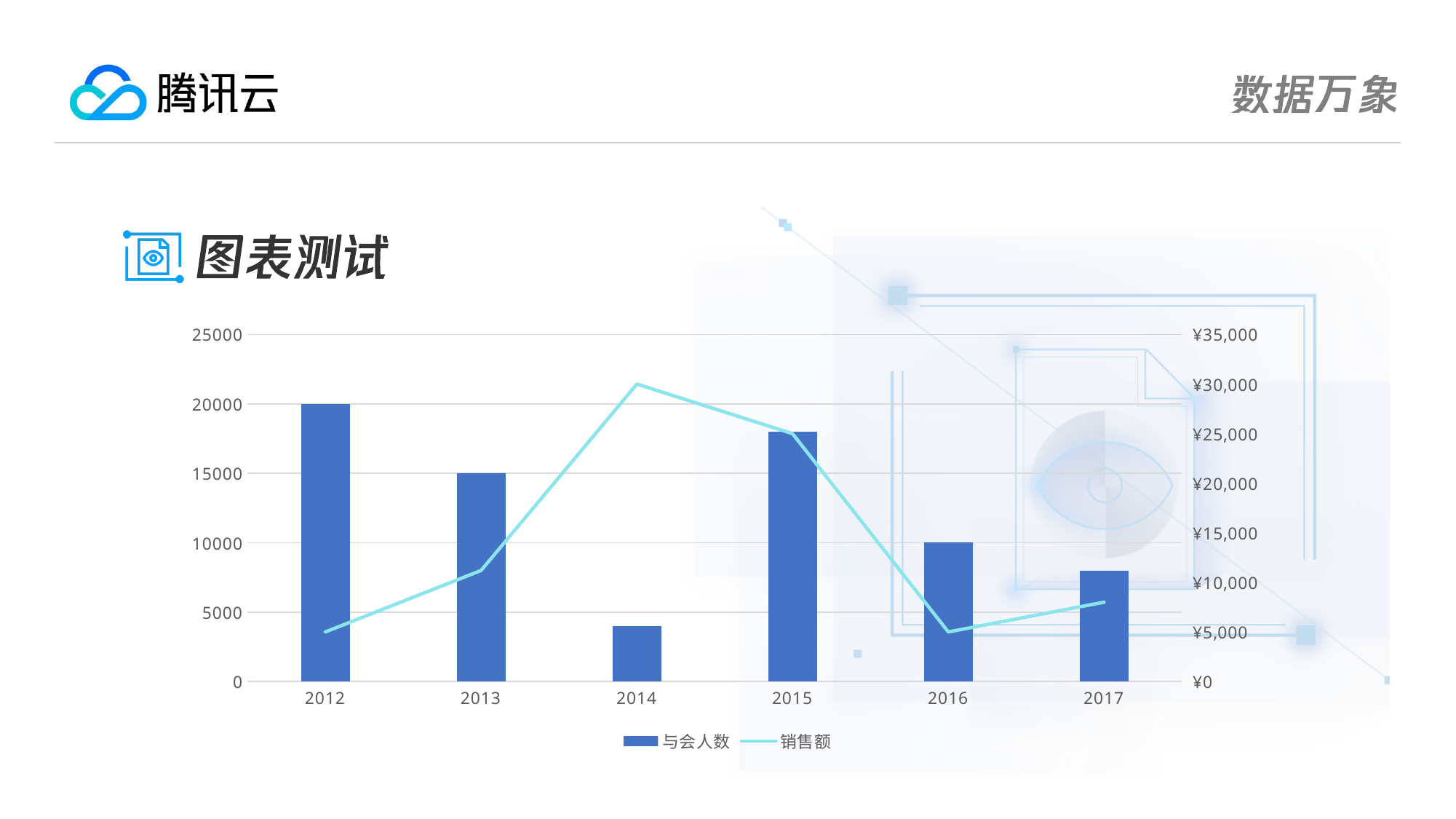
Which year has a larger 与会人数, 2015 or 2016? 2015 What is the 销售额 value for 2014? ¥30,000 What is the difference in 与会人数 between 2012 and 2013? 5000 What is the value of 与会人数 for 2013? 15000 What is the value of 与会人数 for 2016? 10000 Which year has the highest 与会人数? 2012 Is the 与会人数 value for 2014 greater or less than 5000? less What is the value of 与会人数 for 2012? 20000 Which year has the lowest 与会人数? 2014 In which year does 销售额 reach its highest point? 2014 How many series does the legend list? 2 How many years are shown on the x axis? 6